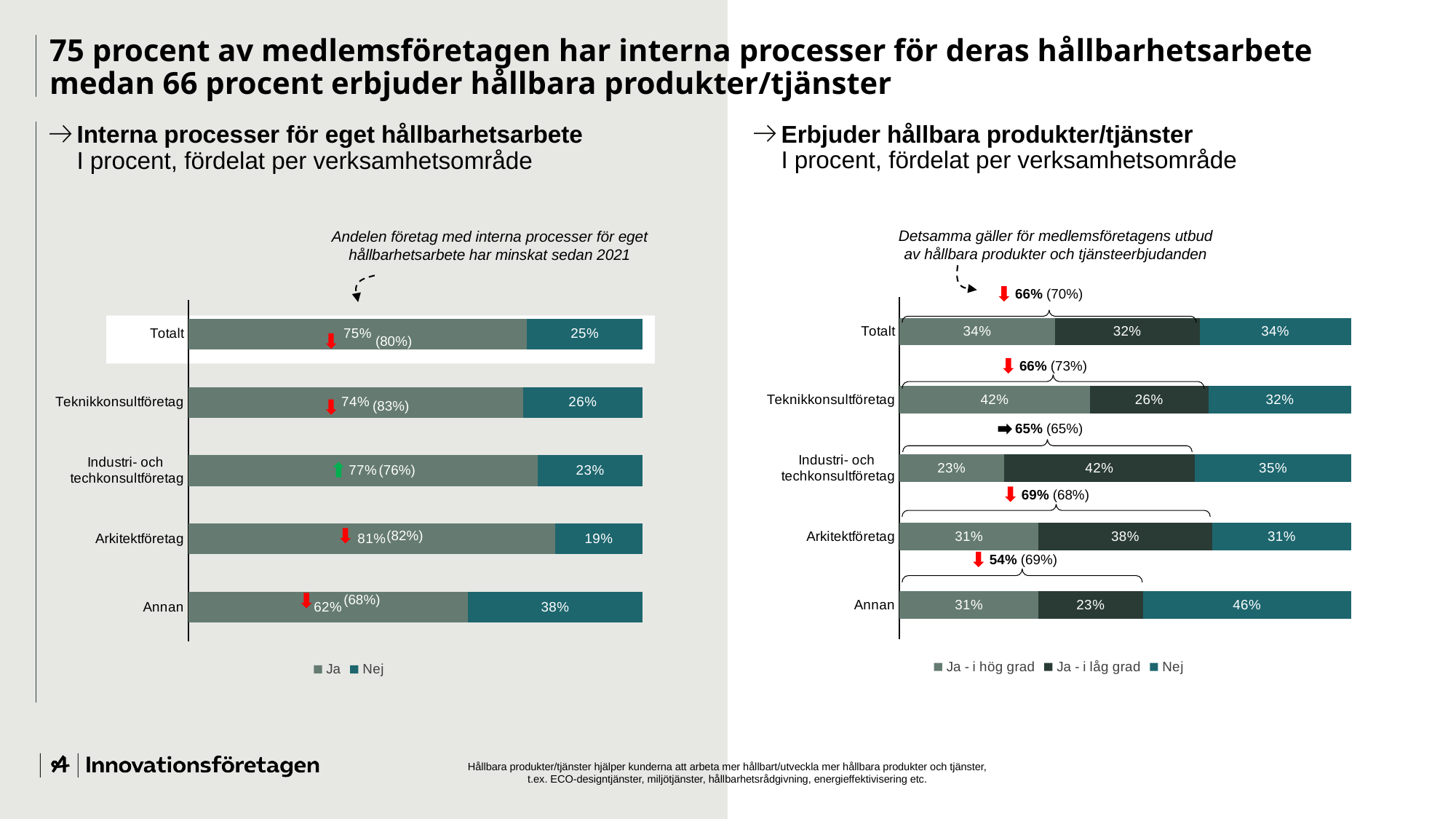
In the chart 'Interna processer för eget hållbarhetsarbete', what is the 'Nej' value for Annan? 38% In the chart 'Erbjuder hållbara produkter/tjänster', is the 'Nej' value larger for Annan or for Teknikkonsultföretag? Annan In the chart 'Interna processer för eget hållbarhetsarbete', which category has the highest 'Ja' value? Arkitektföretag In the chart 'Erbjuder hållbara produkter/tjänster', which category has the highest 'Ja - i hög grad' value? Teknikkonsultföretag In the chart 'Erbjuder hållbara produkter/tjänster', how many categories are shown on the vertical axis? 5 What kind of chart is 'Erbjuder hållbara produkter/tjänster'? Stacked bar chart In the chart 'Interna processer för eget hållbarhetsarbete', what is the 'Ja' value for Arkitektföretag? 81% In the chart 'Erbjuder hållbara produkter/tjänster', what is the 'Nej' value for Annan? 46% In the chart 'Interna processer för eget hållbarhetsarbete', which category has the lowest 'Ja' value? Annan In the chart 'Erbjuder hållbara produkter/tjänster', what is the 'Ja - i låg grad' value for Industri- och techkonsultföretag? 42% In the chart 'Interna processer för eget hållbarhetsarbete', how many series does the legend list? 2 In the chart 'Interna processer för eget hållbarhetsarbete', what is the difference between the 'Ja' values for Arkitektföretag and Annan? 19 percentage points